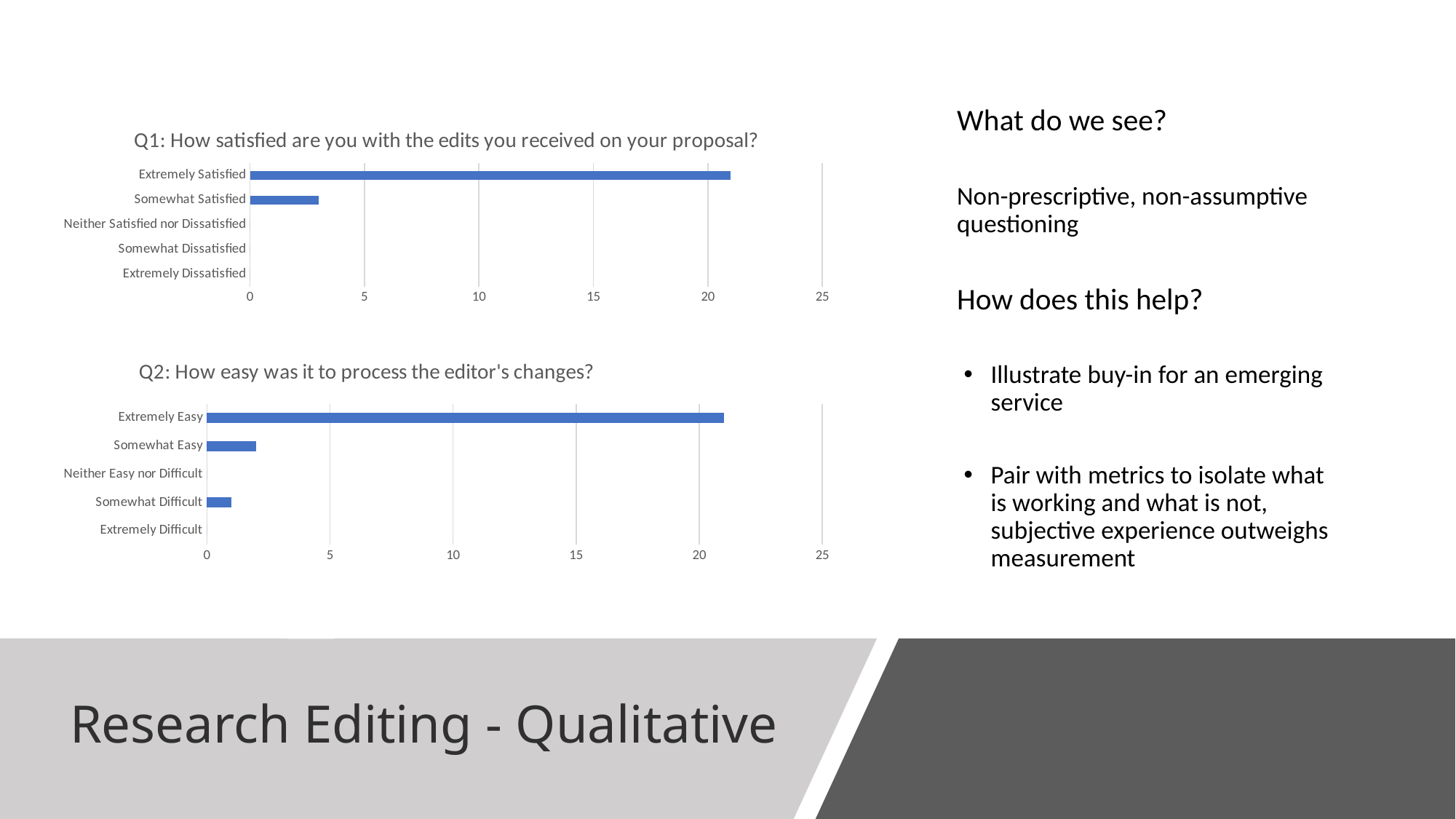
In the Q1 chart, is the value for Extremely Satisfied greater or less than 20? greater In the Q2 chart, which is larger: Somewhat Easy or Somewhat Difficult? Somewhat Easy In the Q2 chart, is the value for Somewhat Easy greater or less than 5? less In the chart titled "Q1: How satisfied are you with the edits you received on your proposal?", which category has the highest value? Extremely Satisfied In the Q1 chart, is the value for Somewhat Satisfied greater or less than 5? less How many categories are shown on the y axis of the Q1 chart? 5 How many categories are shown on the y axis of the Q2 chart? 5 In the Q1 chart, which is larger: Extremely Satisfied or Somewhat Satisfied? Extremely Satisfied What kind of chart is the Q1 chart? Bar chart In the chart titled "Q2: How easy was it to process the editor's changes?", which category has the highest value? Extremely Easy What is the maximum value shown on the x axis of the Q2 chart? 25